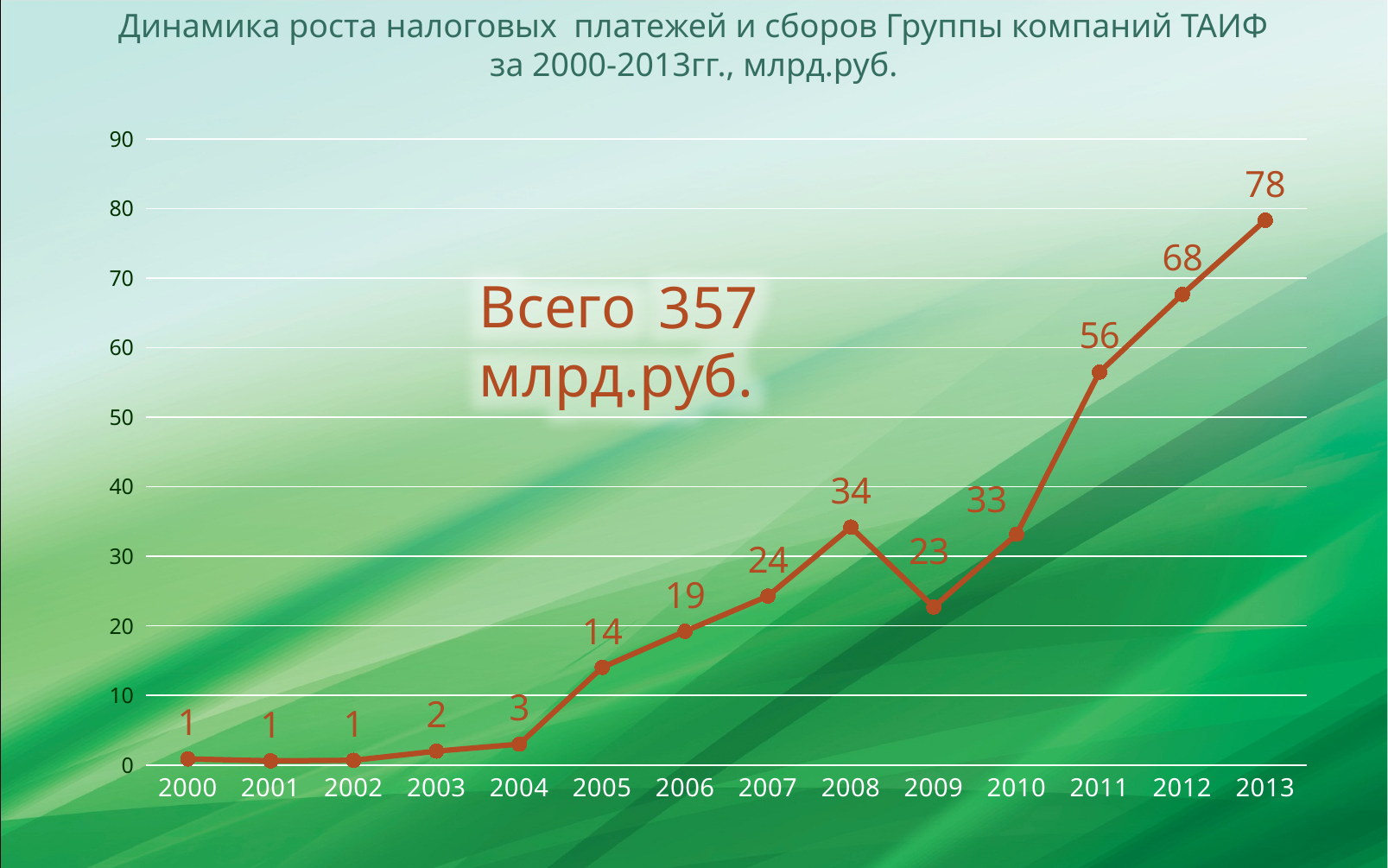
How many years are plotted on the chart? 14 What kind of chart is shown on the slide? line chart What is the difference between the values for 2013 and 2012? 10 Which is larger, the value for 2008 or the value for 2009? 2008 What is the value for 2008? 34 What total is stated in the text on the chart? Всего 357 млрд.руб. Do the values generally rise or fall from 2000 to 2013? rise Which is larger, the value for 2010 or the value for 2011? 2011 What is the value for 2005? 14 What is the difference between the values for 2008 and 2009? 11 What is the value for 2013? 78 Which year has the highest value? 2013